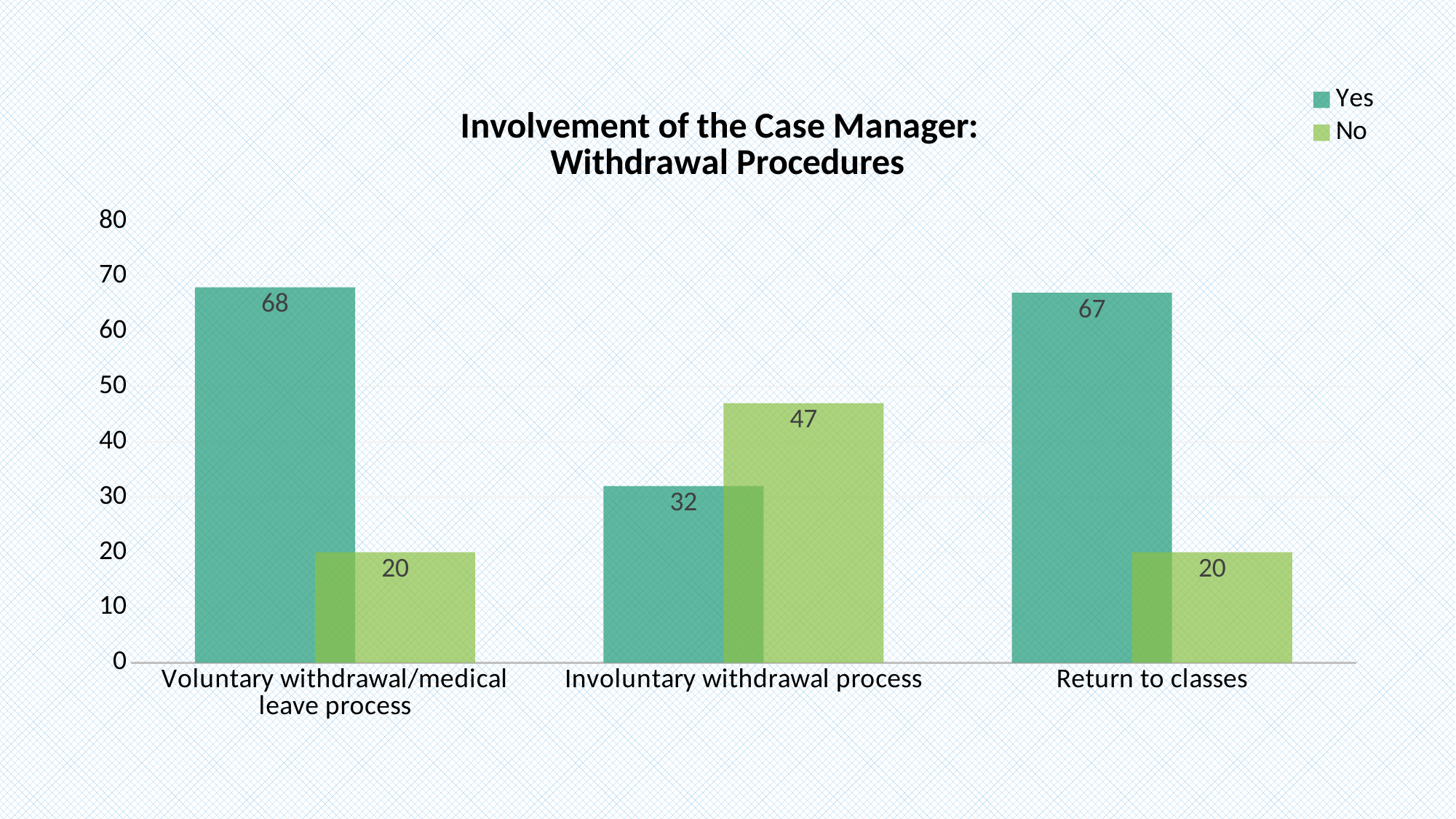
For Involuntary withdrawal process, which is larger, 'Yes' or 'No'? No Which category has the highest 'No' value? Involuntary withdrawal process What is the difference between the 'No' and 'Yes' values for Involuntary withdrawal process? 15 What is the 'No' value for Involuntary withdrawal process? 47 What is the 'Yes' value for Voluntary withdrawal/medical leave process? 68 Which category has the highest 'Yes' value? Voluntary withdrawal/medical leave process What is the 'Yes' value for Return to classes? 67 Which category has the lowest 'Yes' value? Involuntary withdrawal process What kind of chart is shown on the slide? Bar chart What is the 'No' value for Return to classes? 20 How many categories are shown on the x axis? 3 How many series does the legend list? 2